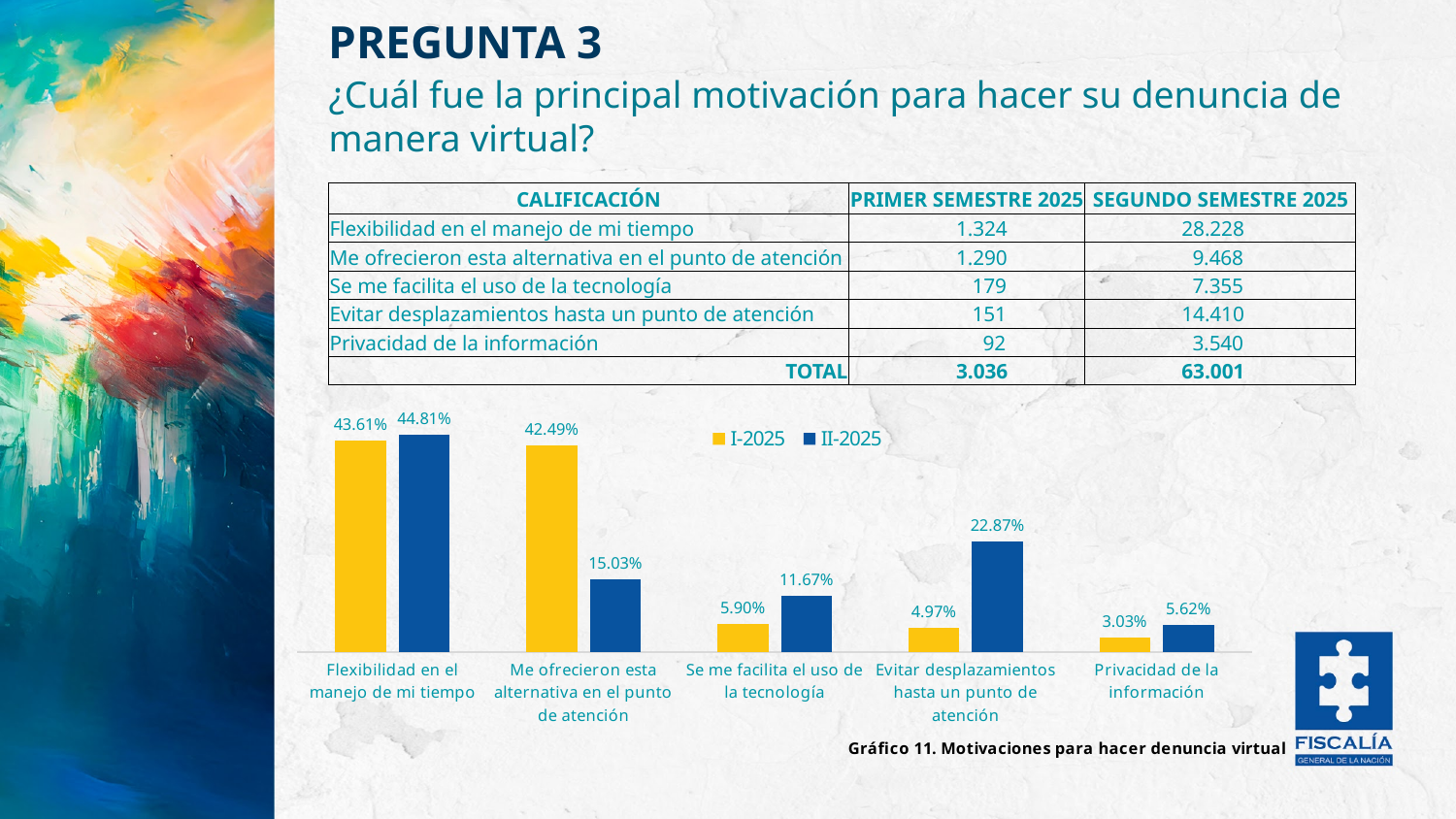
What is the difference between the II-2025 and I-2025 values for "Evitar desplazamientos hasta un punto de atención"? 17.90% What kind of chart is shown on the slide? Bar chart How many series does the chart legend list? 2 Which category has the highest II-2025 value? Flexibilidad en el manejo de mi tiempo What is the II-2025 value for "Evitar desplazamientos hasta un punto de atención"? 22.87% What is the difference between the I-2025 and II-2025 values for "Me ofrecieron esta alternativa en el punto de atención"? 27.46% Which category has the lowest I-2025 value? Privacidad de la información What is the II-2025 value for "Me ofrecieron esta alternativa en el punto de atención"? 15.03% For "Se me facilita el uso de la tecnología", which series has the larger value, I-2025 or II-2025? II-2025 What is the I-2025 value for "Privacidad de la información"? 3.03% How many categories are shown on the x axis of the chart? 5 What is the I-2025 value for "Flexibilidad en el manejo de mi tiempo"? 43.61%